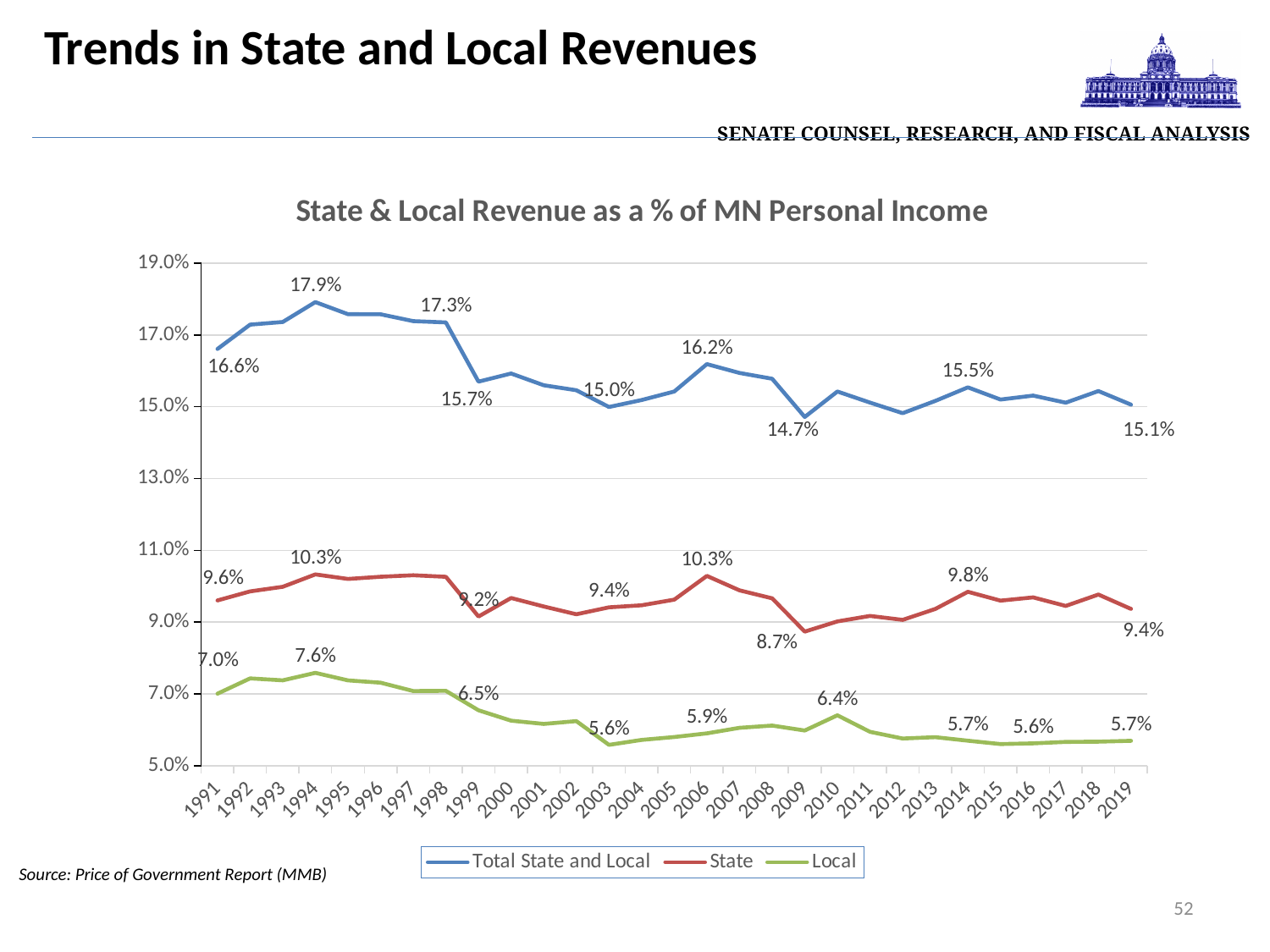
What is the difference between the State revenue values in 2006 and 2009? 1.6 percentage points What kind of chart is shown on the slide? Line chart Which year had the higher State revenue value, 1994 or 2019? 1994 What was Total State and Local revenue as a % of MN personal income in 1994? 17.9% In which year was Total State and Local revenue highest? 1994 How many series does the legend list? 3 Is the Local revenue value for 2001 greater or less than 7.0%? less What was the State revenue value in 2009? 8.7% In which year was Total State and Local revenue lowest? 2009 By how many percentage points did Total State and Local revenue fall from 1994 to 2019? 2.8 percentage points What was the Local revenue value in 1991? 7.0% What was the Local revenue value in 2019? 5.7%